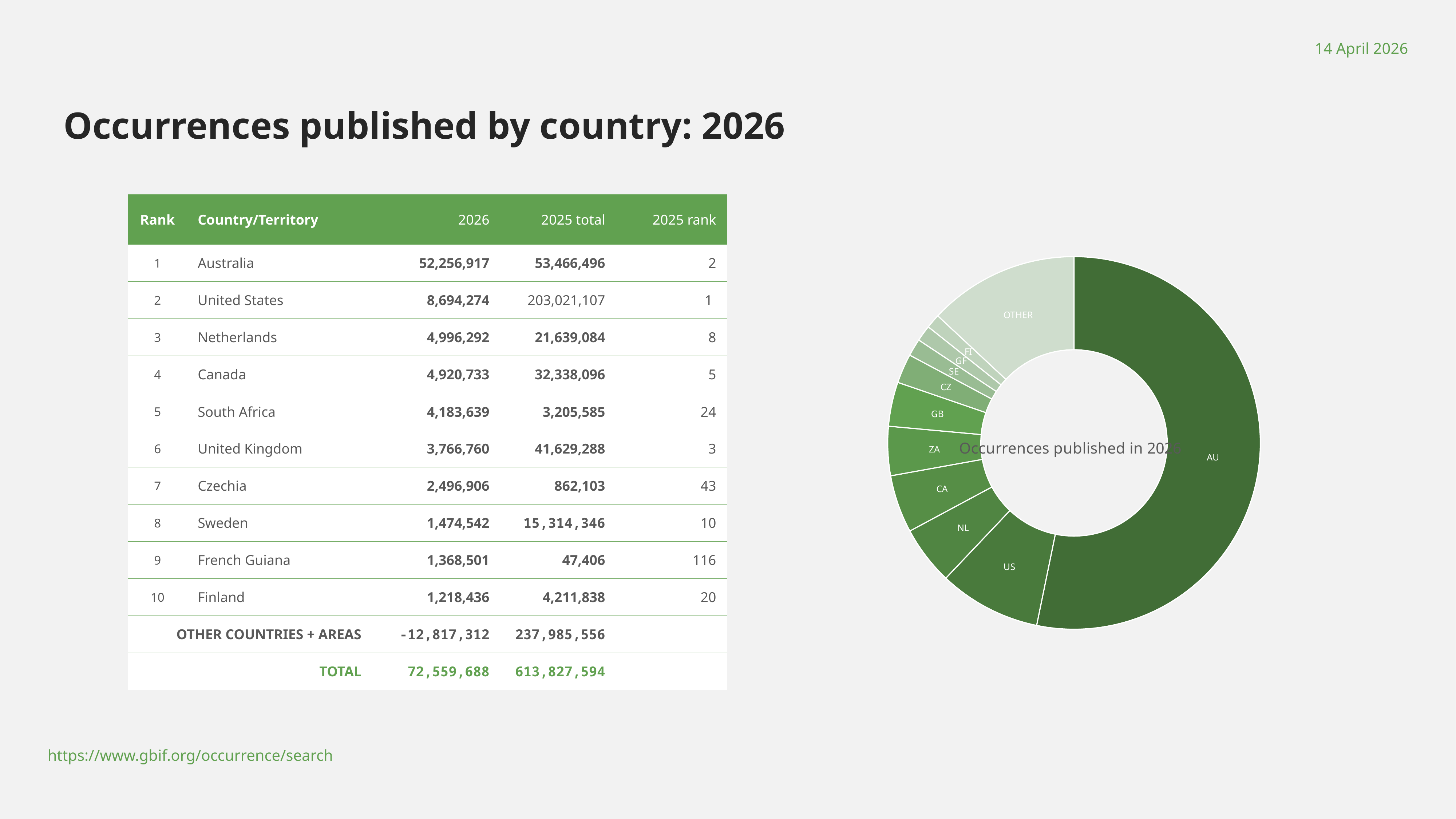
Which slice of the donut chart is the largest? AU In the donut chart, which slice is larger, GB or CZ? GB Which slice of the donut chart is shown in the lightest shade of green? OTHER According to the table, what is the total number of occurrences published in 2026? 72,559,688 Which labelled country slice of the donut chart is the smallest (excluding OTHER)? FI What kind of chart is shown on the right of the slide? pie chart (donut) In the donut chart, which slice is larger, AU or US? AU In the donut chart, which slice is larger, US or NL? US What is the title shown in the centre of the donut chart? Occurrences published in 2026 How many slices does the donut chart have, including OTHER? 11 According to the table, how many occurrences did Australia (AU) publish in 2026? 52,256,917 According to the table, how many occurrences did the United States (US) publish in 2026? 8,694,274